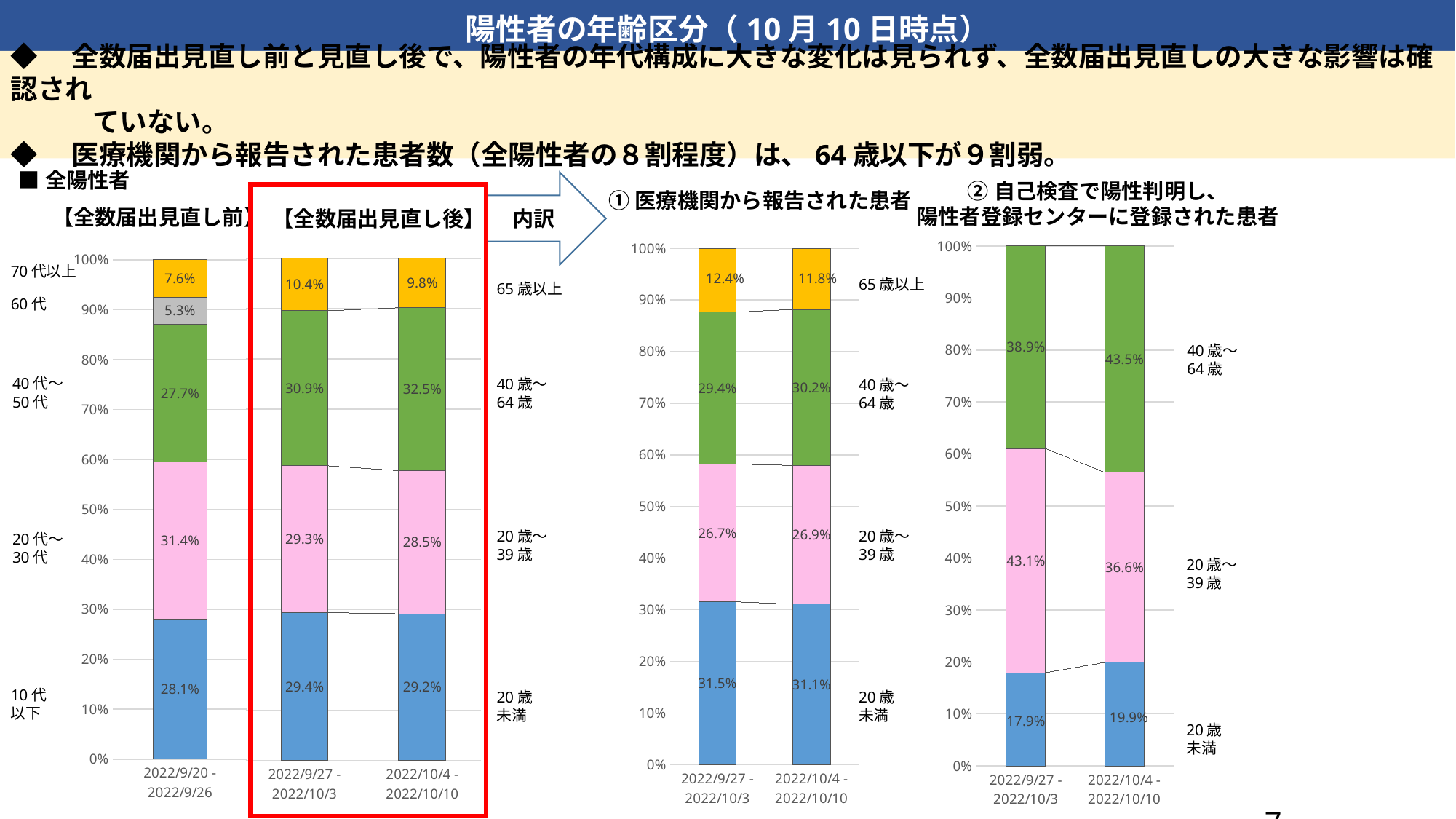
What kind of chart is the middle chart (① 医療機関から報告された患者)? Stacked bar chart How many bars (time periods) are shown in the left chart (全陽性者)? 3 In the right chart (② 自己検査で陽性判明し、陽性者登録センターに登録された患者), which segment is the largest in the 2022/10/4 - 2022/10/10 bar? 40歳～64歳 In the right chart (② 自己検査で陽性判明し、陽性者登録センターに登録された患者), what is the value for 20歳～39歳 in the 2022/9/27 - 2022/10/3 bar? 43.1% In the middle chart (① 医療機関から報告された患者), what is the value for 40歳～64歳 in the 2022/10/4 - 2022/10/10 bar? 30.2% In the left chart (全陽性者), what is the value for 20歳未満 in the 2022/10/4 - 2022/10/10 bar? 29.2% In the middle chart (① 医療機関から報告された患者), is the 65歳以上 value larger in the 2022/9/27 - 2022/10/3 bar or the 2022/10/4 - 2022/10/10 bar? 2022/9/27 - 2022/10/3 In the left chart (全陽性者), does the 40歳～64歳 share rise or fall from the 2022/9/27 - 2022/10/3 bar to the 2022/10/4 - 2022/10/10 bar? Rise In the left chart (全陽性者), what is the value for 65歳以上 in the 2022/9/27 - 2022/10/3 bar? 10.4% In the left chart (全陽性者), what is the value for 60代 in the 2022/9/20 - 2022/9/26 bar? 5.3% In the right chart (② 自己検査で陽性判明し、陽性者登録センターに登録された患者), what is the difference between the 20歳未満 values for 2022/10/4 - 2022/10/10 and 2022/9/27 - 2022/10/3? 2.0% In the middle chart (① 医療機関から報告された患者), which segment is the smallest in the 2022/9/27 - 2022/10/3 bar? 65歳以上